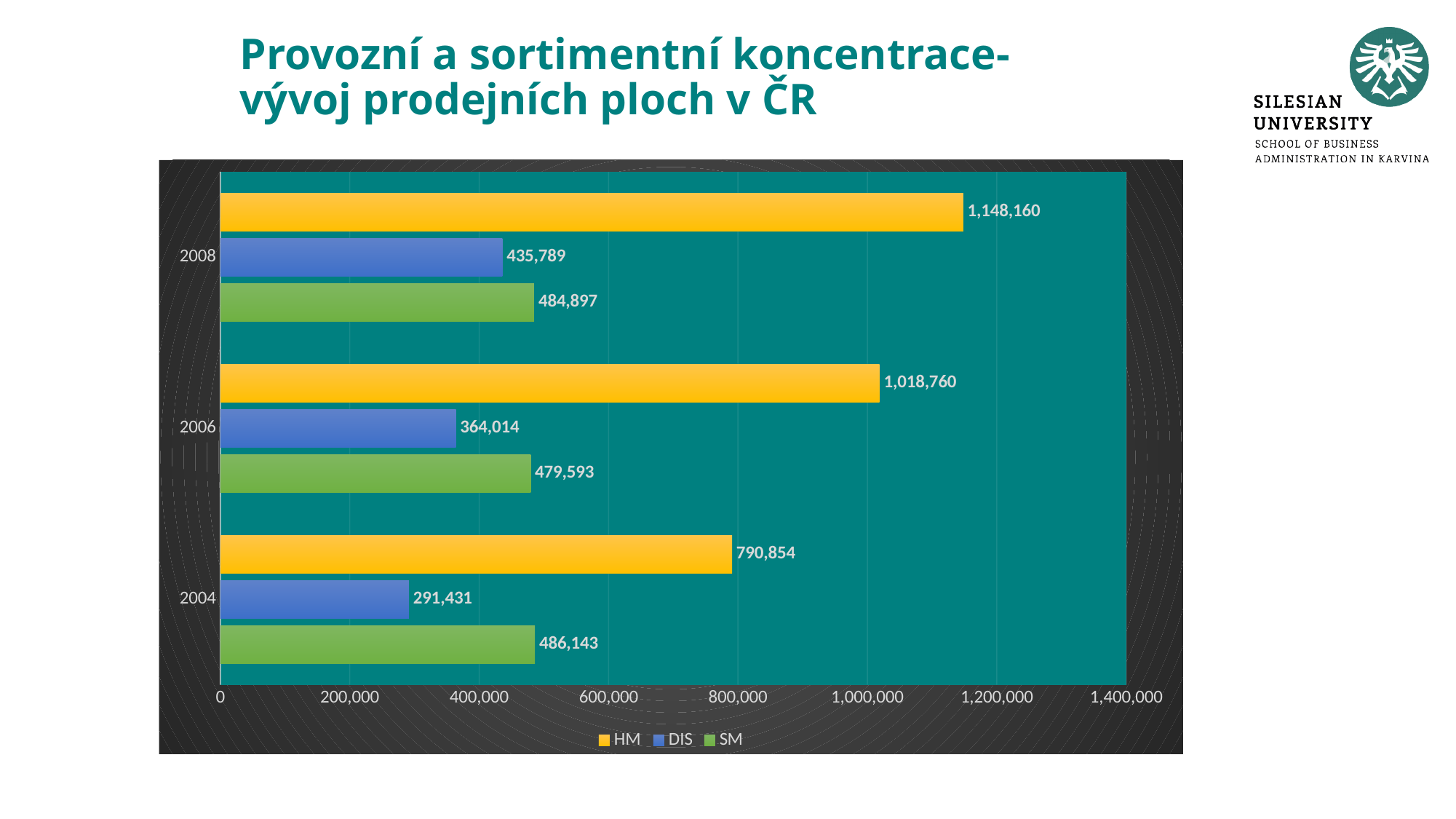
Which series is shown in yellow in the legend? HM Which is larger in 2006: the DIS value or the SM value? SM Does the HM value rise or fall from 2004 to 2008? rise What is the value for DIS in 2006? 364,014 What is the value for HM in 2008? 1,148,160 In which year is the DIS value lowest? 2004 What type of chart is shown on the slide? bar chart How many years (categories) are shown on the chart? 3 What is the value for SM in 2004? 486,143 In which year is the HM value highest? 2008 What is the difference between the HM values for 2008 and 2006? 129,400 How many series does the legend list? 3